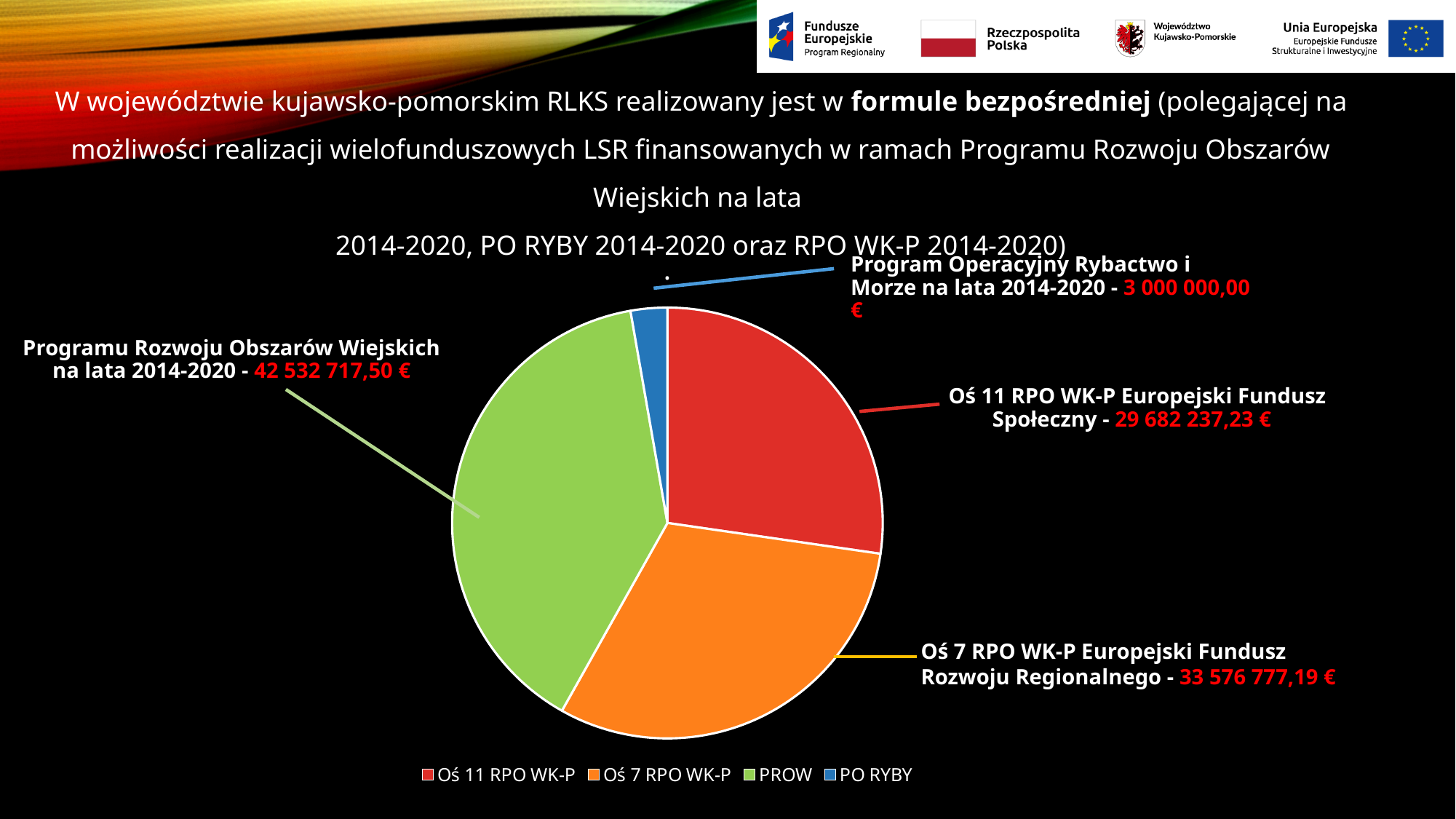
How many slices does the pie chart have? 4 What is the value for Oś 11 RPO WK-P Europejski Fundusz Społeczny in the pie chart? 29 682 237,23 € What is the difference between the PROW value and the Oś 7 RPO WK-P value in the pie chart? 8 955 940,31 € Which slice of the pie chart has the smallest value? PO RYBY What type of chart is shown on the slide? Pie chart Which slice of the pie chart has the largest value? PROW How many entries does the legend of the pie chart list? 4 What is the value for Oś 7 RPO WK-P Europejski Fundusz Rozwoju Regionalnego in the pie chart? 33 576 777,19 € What is the value for PROW (Programu Rozwoju Obszarów Wiejskich na lata 2014-2020) in the pie chart? 42 532 717,50 € What is the value for PO RYBY (Program Operacyjny Rybactwo i Morze na lata 2014-2020) in the pie chart? 3 000 000,00 € Which is larger in the pie chart: Oś 7 RPO WK-P or Oś 11 RPO WK-P? Oś 7 RPO WK-P What colour is the PROW slice in the pie chart? Green